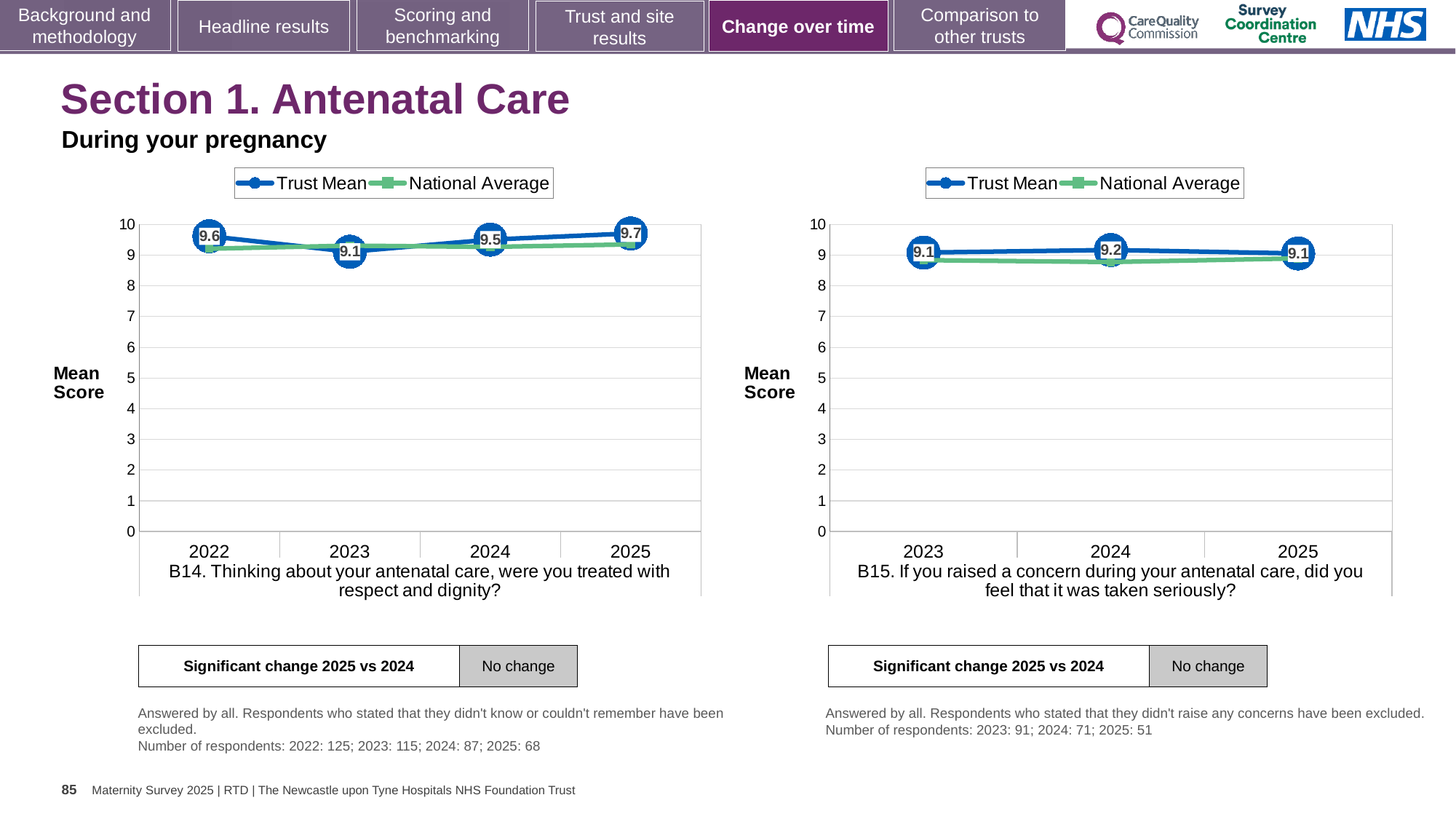
On the B14 chart (left), which year has the lowest Trust Mean? 2023 What kind of chart is the B14 chart (left)? Line chart How many years are shown on the x axis of the B15 chart (right)? 3 How many series does the legend of the B14 chart (left) list? 2 On the B14 chart (left), does the Trust Mean rise or fall from 2023 to 2025? Rise On the B14 chart (left), which year has the highest Trust Mean? 2025 On the B14 chart (left), is the Trust Mean higher in 2022 or in 2024? 2022 On the B15 chart (right), is the National Average for 2023 greater or less than 8? greater On the B15 chart (right), what is the Trust Mean for 2024? 9.2 On the B14 chart (left), what is the Trust Mean for 2025? 9.7 On the B14 chart (left), what is the difference between the Trust Mean in 2025 and in 2023? 0.6 On the B14 chart (left), what is the Trust Mean for 2023? 9.1